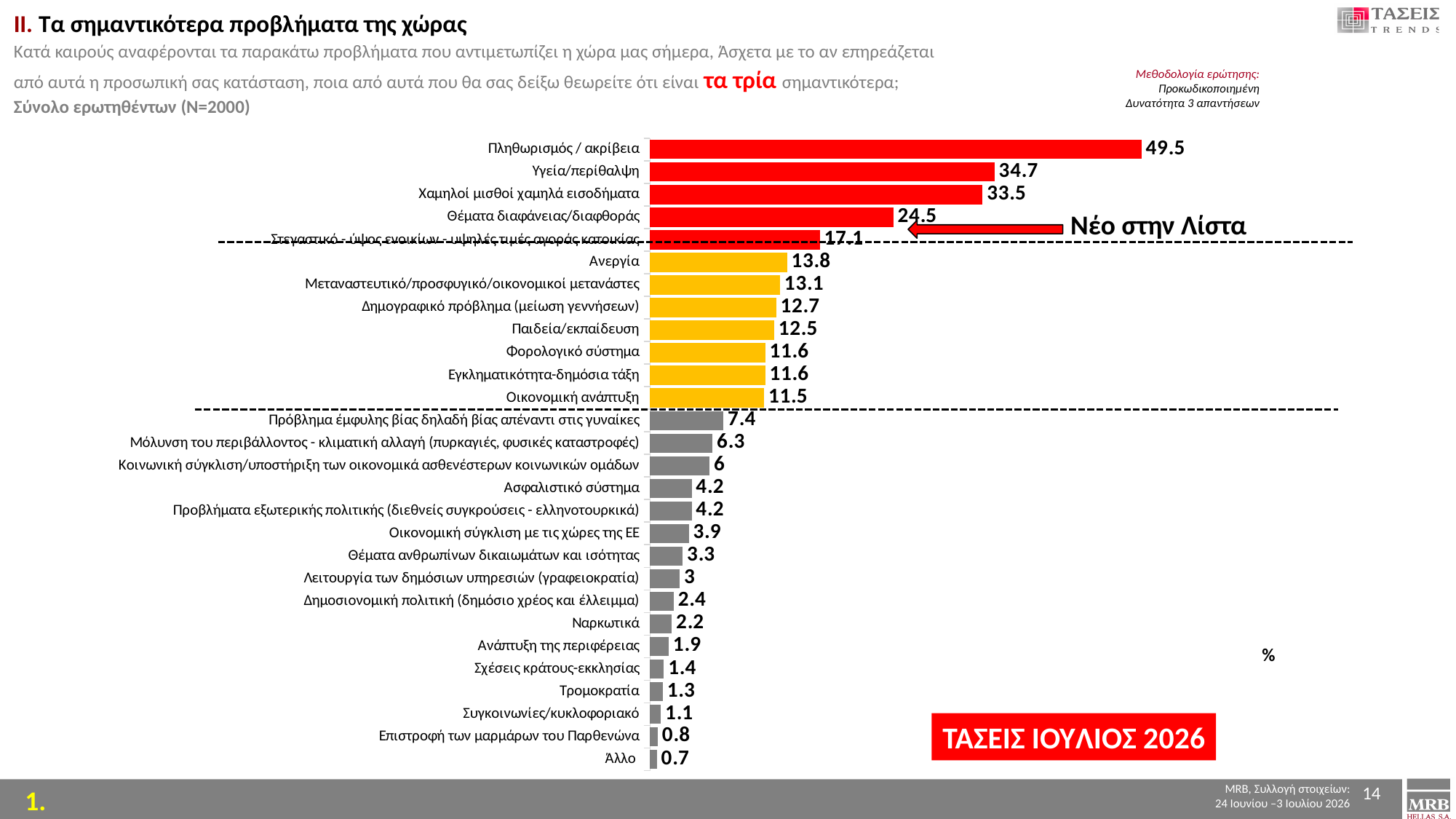
What is the value for Θέματα διαφάνειας/διαφθοράς? 24.5 What is the value for Ναρκωτικά? 2.2 What is the value for Ανεργία? 13.8 What is the difference between the values for Υγεία/περίθαλψη and Χαμηλοί μισθοί χαμηλά εισοδήματα? 1.2 Which category has the highest value? Πληθωρισμός / ακρίβεια Which is larger, the value for Μεταναστευτικό/προσφυγικό/οικονομικοί μετανάστες or the value for Παιδεία/εκπαίδευση? Μεταναστευτικό/προσφυγικό/οικονομικοί μετανάστες What kind of chart is shown on the slide? Bar chart What is the difference between the values for Πληθωρισμός / ακρίβεια and Στεγαστικό? 32.4 How many categories are shown in the chart? 28 Which category has the lowest value? Άλλο What is the value for Πληθωρισμός / ακρίβεια? 49.5